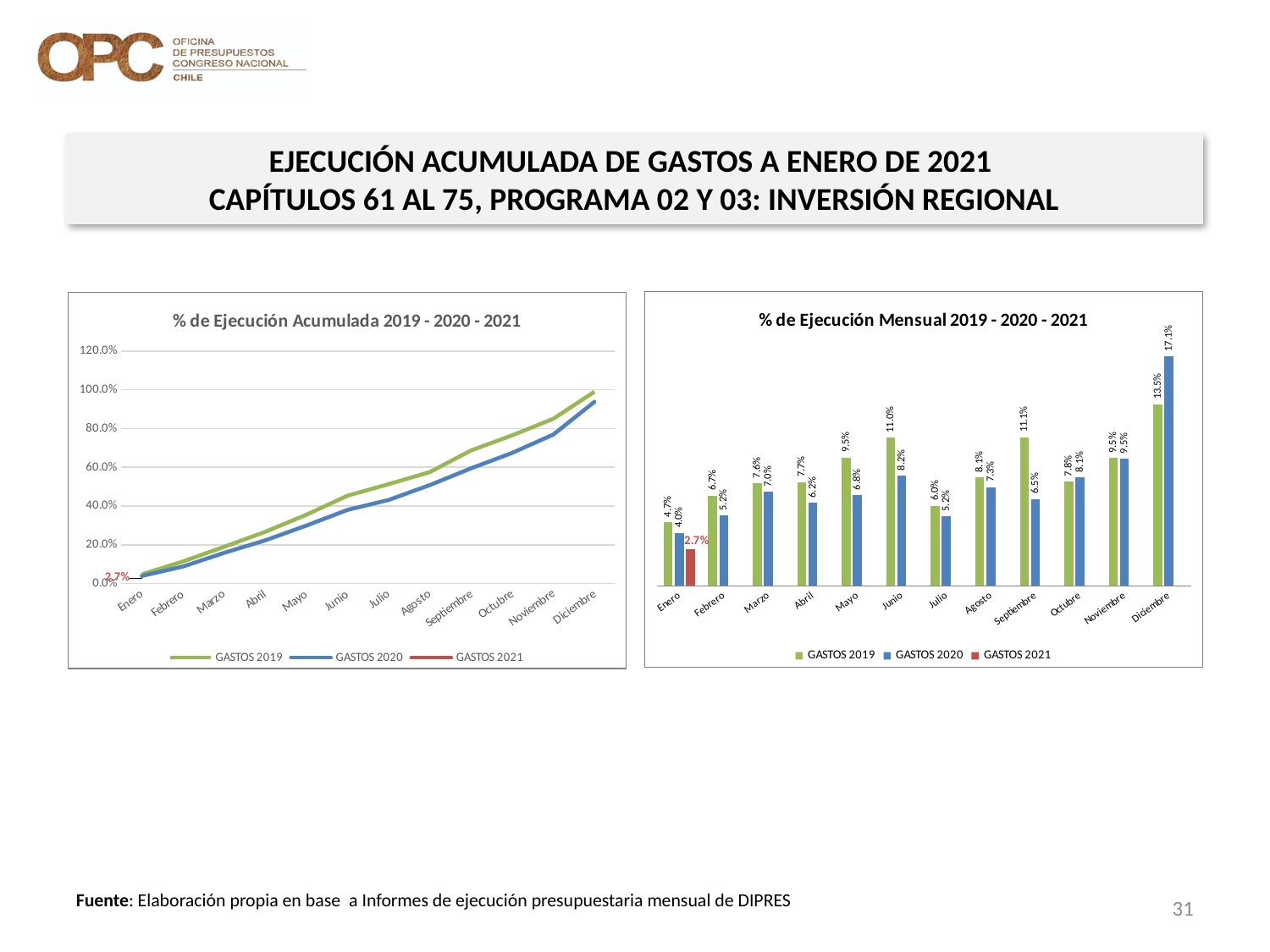
In the '% de Ejecución Mensual' chart, which month has the lowest value for GASTOS 2020? Enero In the '% de Ejecución Mensual' chart, which month has the highest value for GASTOS 2019? Diciembre In the '% de Ejecución Mensual' chart, which is larger in Octubre: GASTOS 2019 or GASTOS 2020? GASTOS 2020 In the '% de Ejecución Mensual' chart, what is the value for GASTOS 2020 in Diciembre? 17.1% What type of chart is the left chart titled '% de Ejecución Acumulada 2019 - 2020 - 2021'? Line chart In the '% de Ejecución Mensual' chart, what is the value for GASTOS 2019 in Septiembre? 11.1% In the '% de Ejecución Mensual' chart, what is the value for GASTOS 2021 in Enero? 2.7% In the '% de Ejecución Mensual' chart, what is the difference between GASTOS 2020 and GASTOS 2019 in Diciembre? 3.6% How many series does the legend of the '% de Ejecución Mensual' chart list? 3 What type of chart is the right chart titled '% de Ejecución Mensual 2019 - 2020 - 2021'? Bar chart How many months are shown on the x axis of the '% de Ejecución Acumulada' chart? 12 In the '% de Ejecución Acumulada' chart, is the value for GASTOS 2019 in Diciembre greater or less than 80.0%? greater